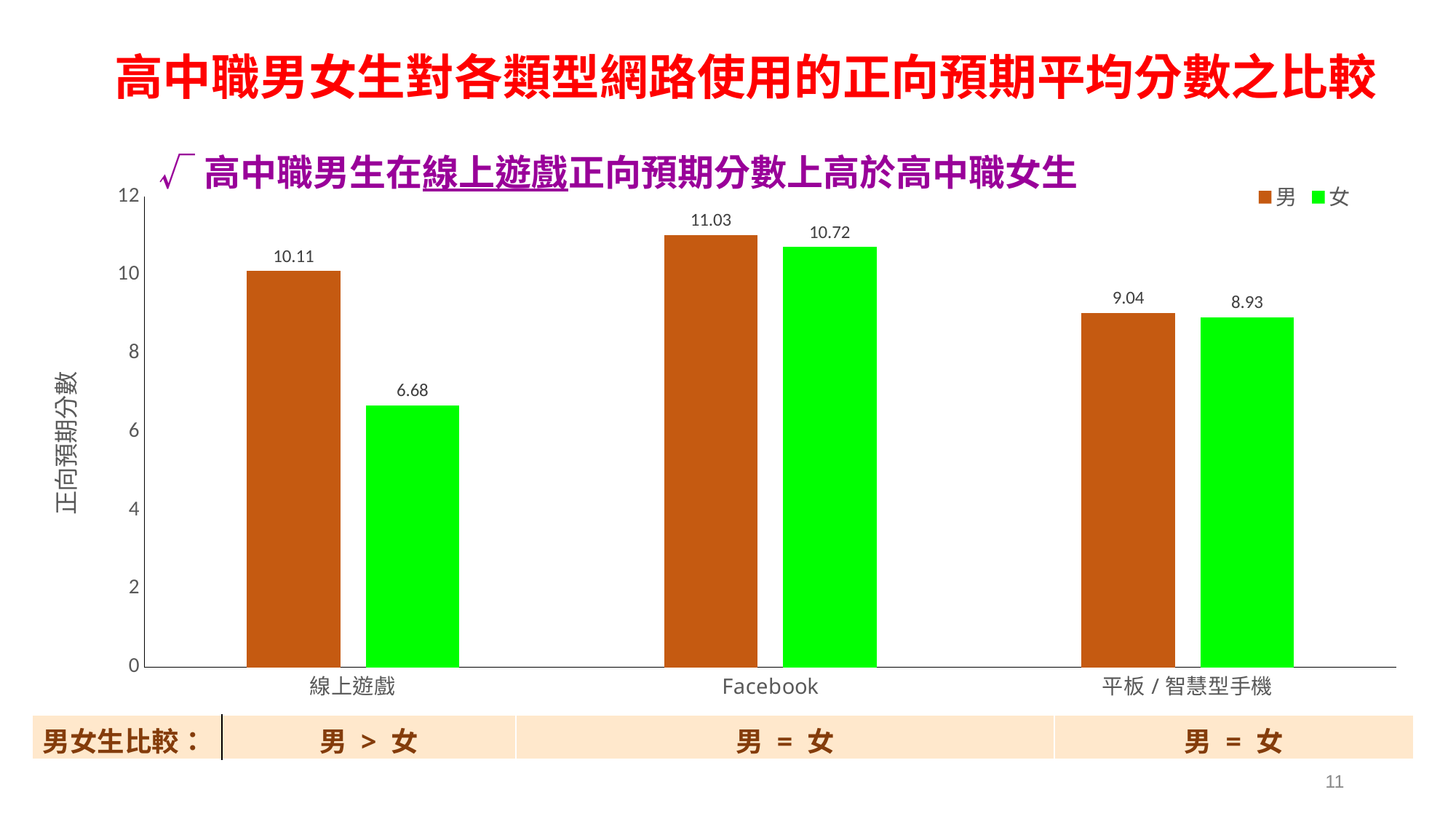
How many series does the legend list? 2 What is the difference between the 男 and 女 values in the 線上遊戲 category? 3.43 What is the value for 女 in the 平板 / 智慧型手機 category? 8.93 Which category has the highest value for the 男 series? Facebook What is the label of the vertical axis? 正向預期分數 What is the value for 女 in the 線上遊戲 category? 6.68 How many categories are shown on the x axis? 3 Which category has the lowest value for the 女 series? 線上遊戲 What is the value for 男 in the Facebook category? 11.03 Which is larger in the Facebook category, the 男 value or the 女 value? 男 What kind of chart is shown on the slide? Bar chart What is the value for 男 in the 線上遊戲 category? 10.11